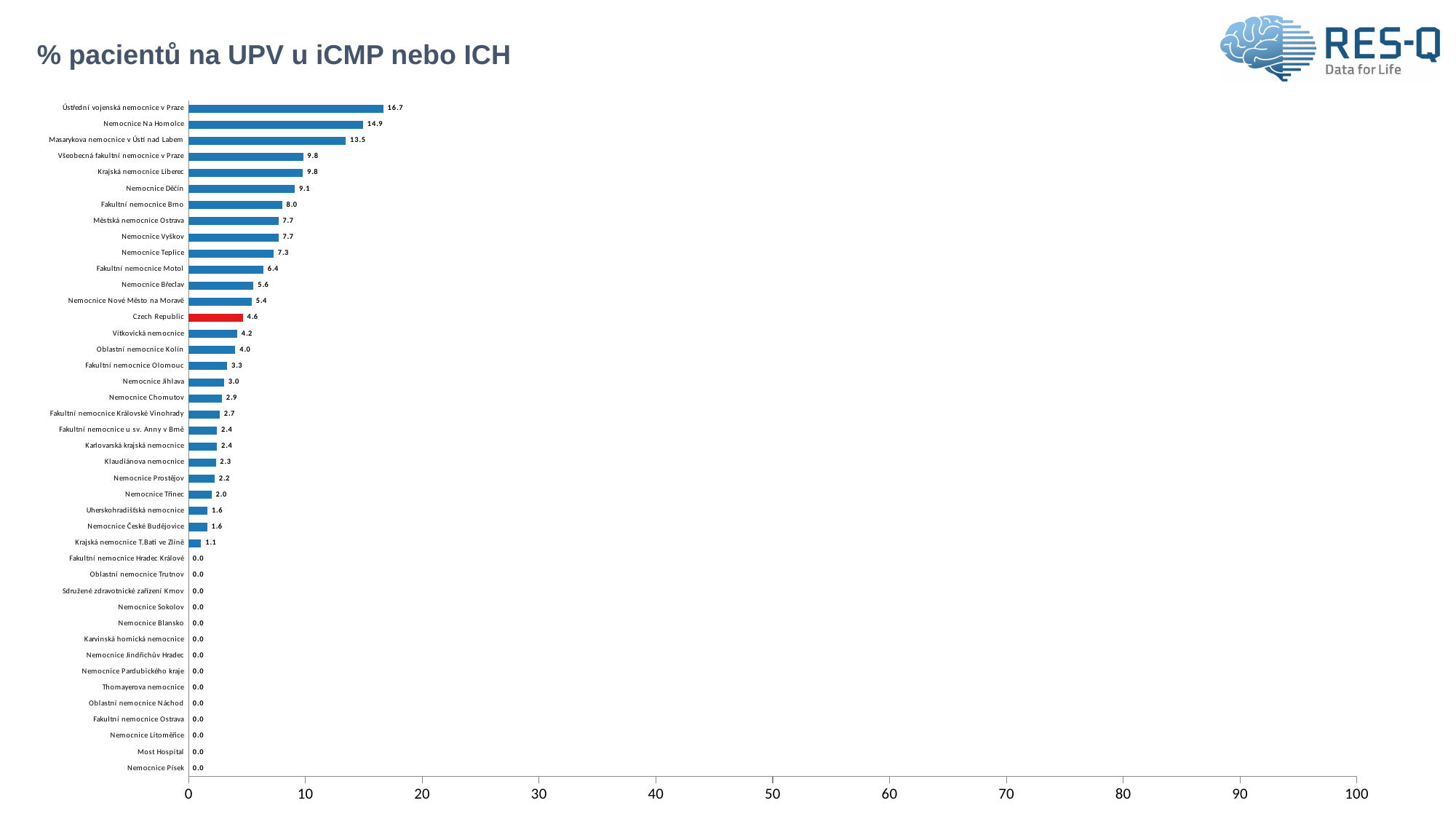
What is the title of the chart? % pacientů na UPV u iCMP nebo ICH What kind of chart is shown on the slide? bar chart What is the value for Ústřední vojenská nemocnice v Praze? 16.7 Which category has the highest value? Ústřední vojenská nemocnice v Praze What is the value for Czech Republic? 4.6 Which is larger, the value for Nemocnice Děčín or the value for Nemocnice Teplice? Nemocnice Děčín What is the value for Fakultní nemocnice Motol? 6.4 Is the value for Nemocnice Na Homolce greater or less than 10? greater What is the value for Krajská nemocnice T.Bati ve Zlíně? 1.1 What is the difference between the values for Nemocnice Na Homolce and Masarykova nemocnice v Ústí nad Labem? 1.4 Which bar is coloured red instead of blue? Czech Republic What is the difference between the values for Fakultní nemocnice Brno and Czech Republic? 3.4